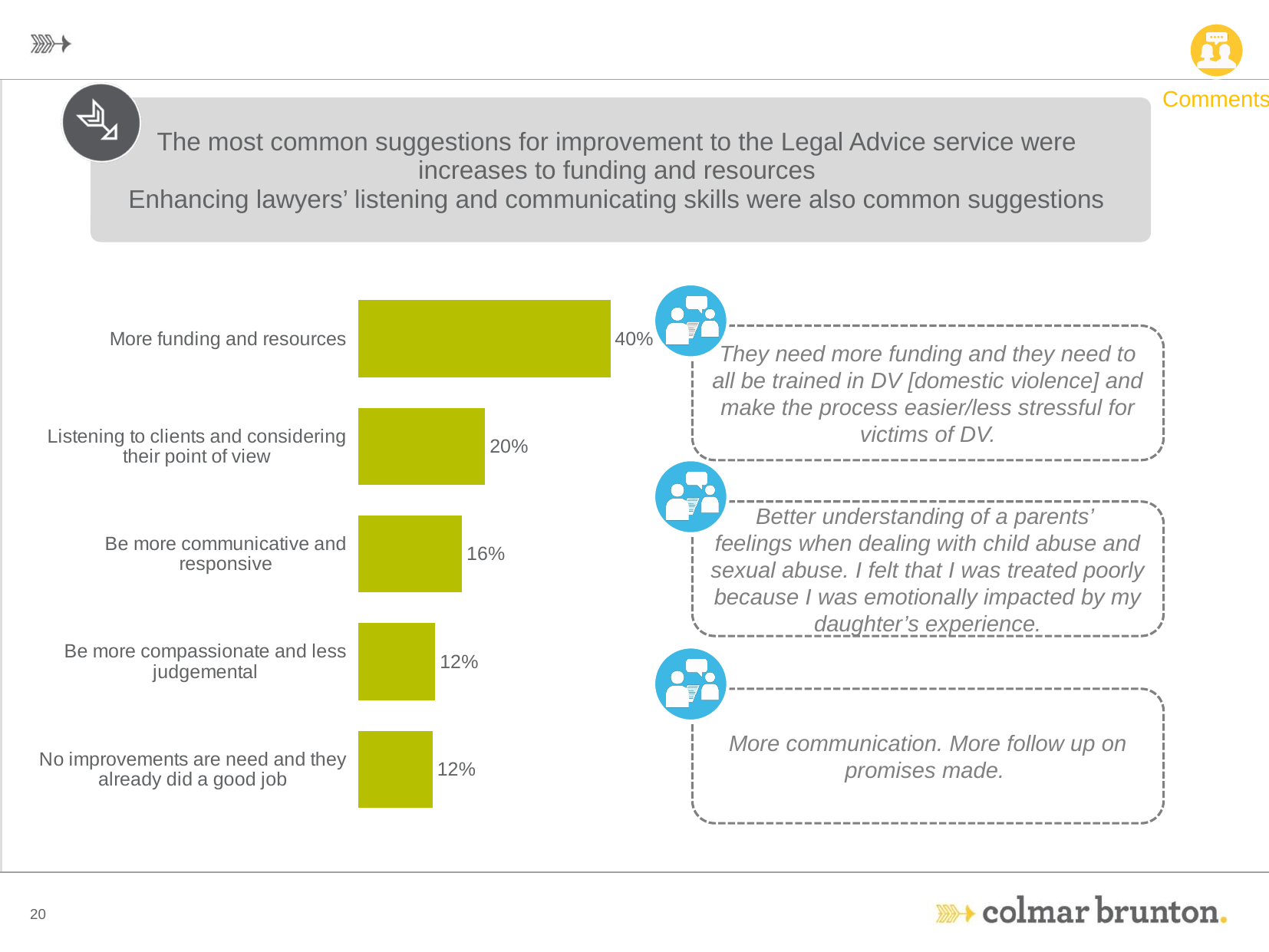
What kind of chart is shown on the slide? Bar chart Which is larger: the value for "Listening to clients and considering their point of view" or the value for "Be more communicative and responsive"? Listening to clients and considering their point of view What is the value for "More funding and resources"? 40% How many categories are shown in the chart? 5 What is the difference between the values for "Be more communicative and responsive" and "Be more compassionate and less judgemental"? 4% What is the value for "Listening to clients and considering their point of view"? 20% What colour are the bars in the chart? Yellow-green What is the difference between the values for "More funding and resources" and "Listening to clients and considering their point of view"? 20% Which two categories share the same value of 12%? Be more compassionate and less judgemental; No improvements are need and they already did a good job What is the value for "Be more communicative and responsive"? 16% What is the value for "Be more compassionate and less judgemental"? 12% Which category has the highest value? More funding and resources